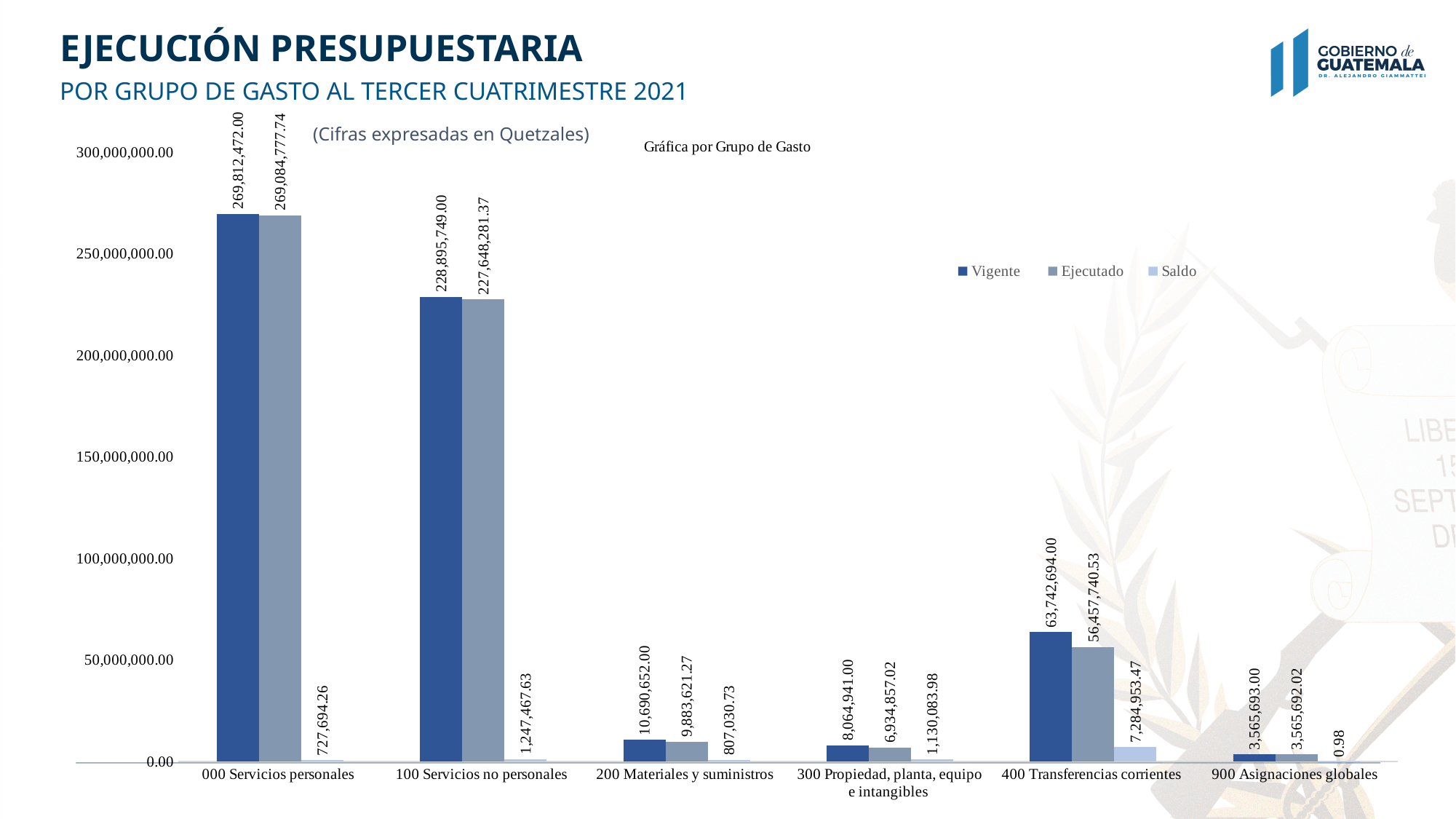
What is the Ejecutado value for 200 Materiales y suministros? 9,883,621.27 Which category has the highest Vigente value? 000 Servicios personales What type of chart is shown on the slide? Bar chart What is the Vigente value for 000 Servicios personales? 269,812,472.00 What is the Saldo value for 900 Asignaciones globales? 0.98 Which category has the lowest Ejecutado value? 900 Asignaciones globales What is the Ejecutado value for 400 Transferencias corrientes? 56,457,740.53 What is the difference between the Vigente and Ejecutado values for 400 Transferencias corrientes? 7,284,953.47 Which is larger: the Vigente value for 200 Materiales y suministros or the Vigente value for 300 Propiedad, planta, equipo e intangibles? 200 Materiales y suministros Is the Vigente value for 100 Servicios no personales greater or less than 200,000,000.00? greater How many series does the legend list? 3 How many expense group categories are shown on the x axis? 6